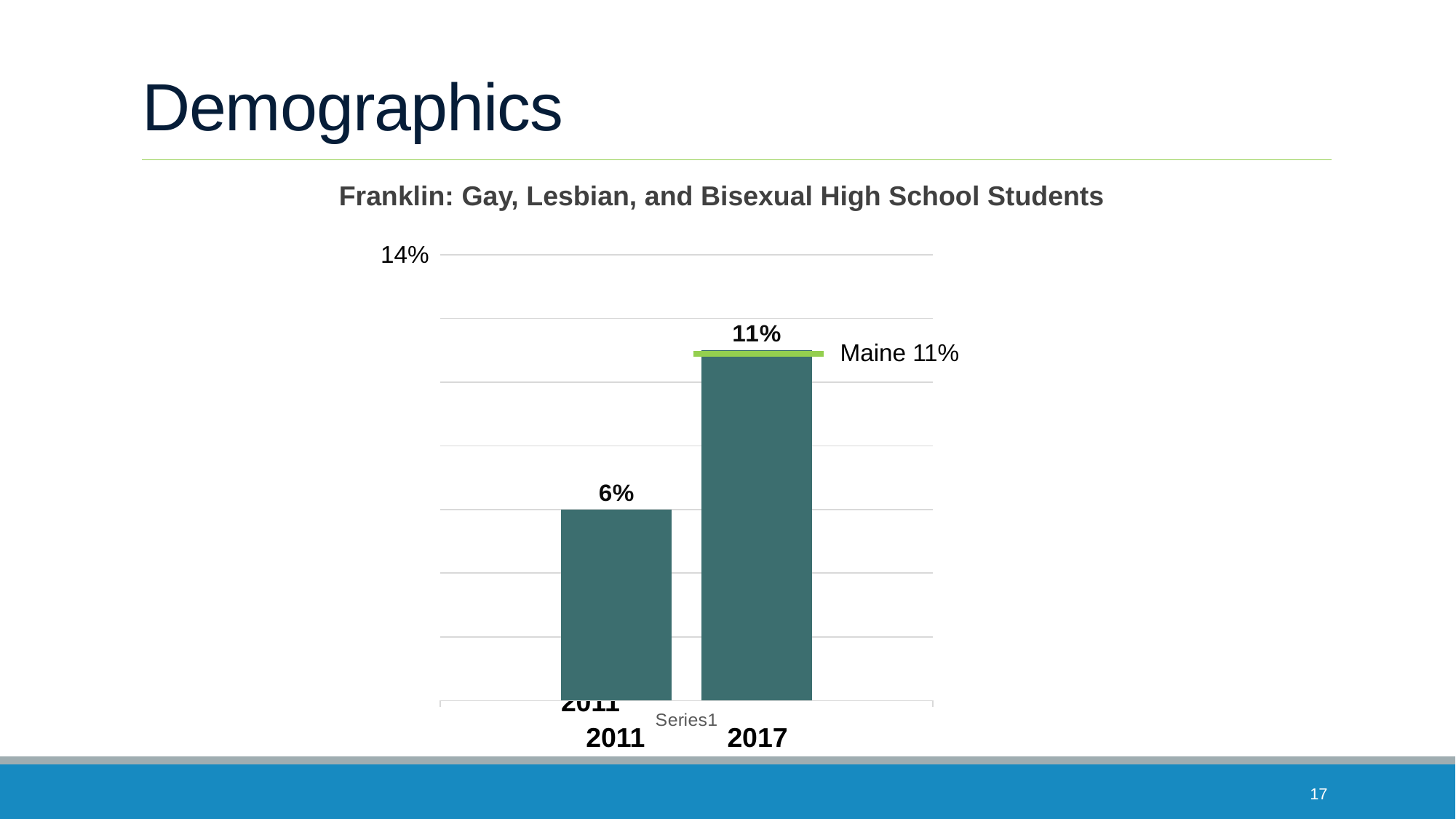
What is the Maine value marked on the chart? 11% Which year has the lower value in the chart? 2011 What is the title of the chart? Franklin: Gay, Lesbian, and Bisexual High School Students Which year has the higher value in the chart? 2017 What is the highest value shown on the vertical axis? 14% How many bars are plotted in the chart? 2 What is the difference between the 2017 and 2011 values? 5% What is the value for 2011 in the Franklin: Gay, Lesbian, and Bisexual High School Students chart? 6% What kind of chart is shown on the slide? bar chart Is the value for 2011 larger or smaller than the value for 2017? smaller Do the values rise or fall from 2011 to 2017? rise What is the value for 2017 in the Franklin: Gay, Lesbian, and Bisexual High School Students chart? 11%